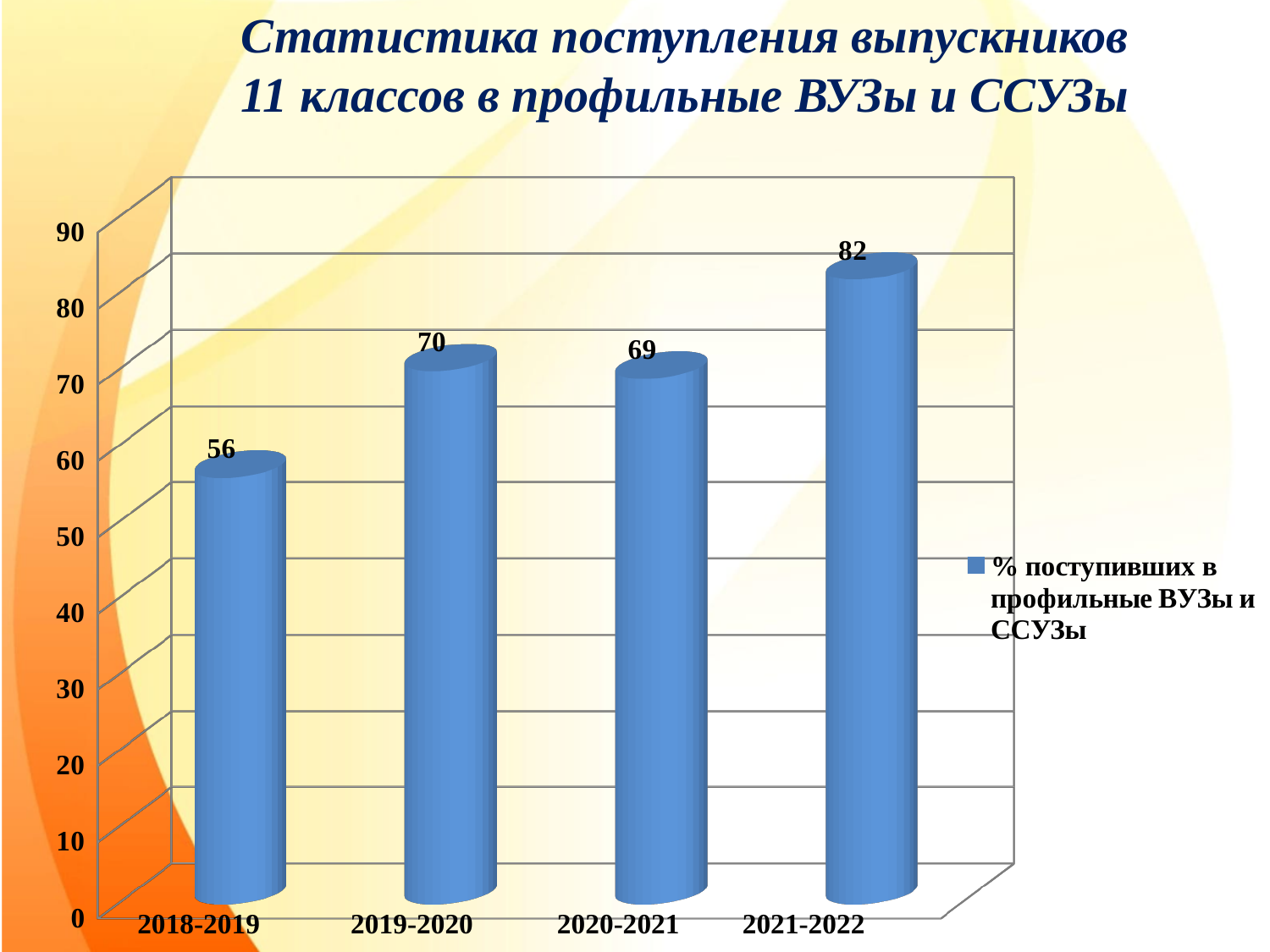
What is the value for 2020-2021? 69 What kind of chart is shown on the slide? Bar chart Which academic year has the lowest value? 2018-2019 What is the value for 2018-2019? 56 How many series does the legend list? 1 Which is larger, the value for 2019-2020 or the value for 2018-2019? 2019-2020 Which academic year has the highest value? 2021-2022 What is the difference between the values for 2021-2022 and 2018-2019? 26 How many academic years are shown on the x axis? 4 What is the value for 2019-2020? 70 What is the value for 2021-2022? 82 What is the legend entry for the series? % поступивших в профильные ВУЗы и ССУЗы